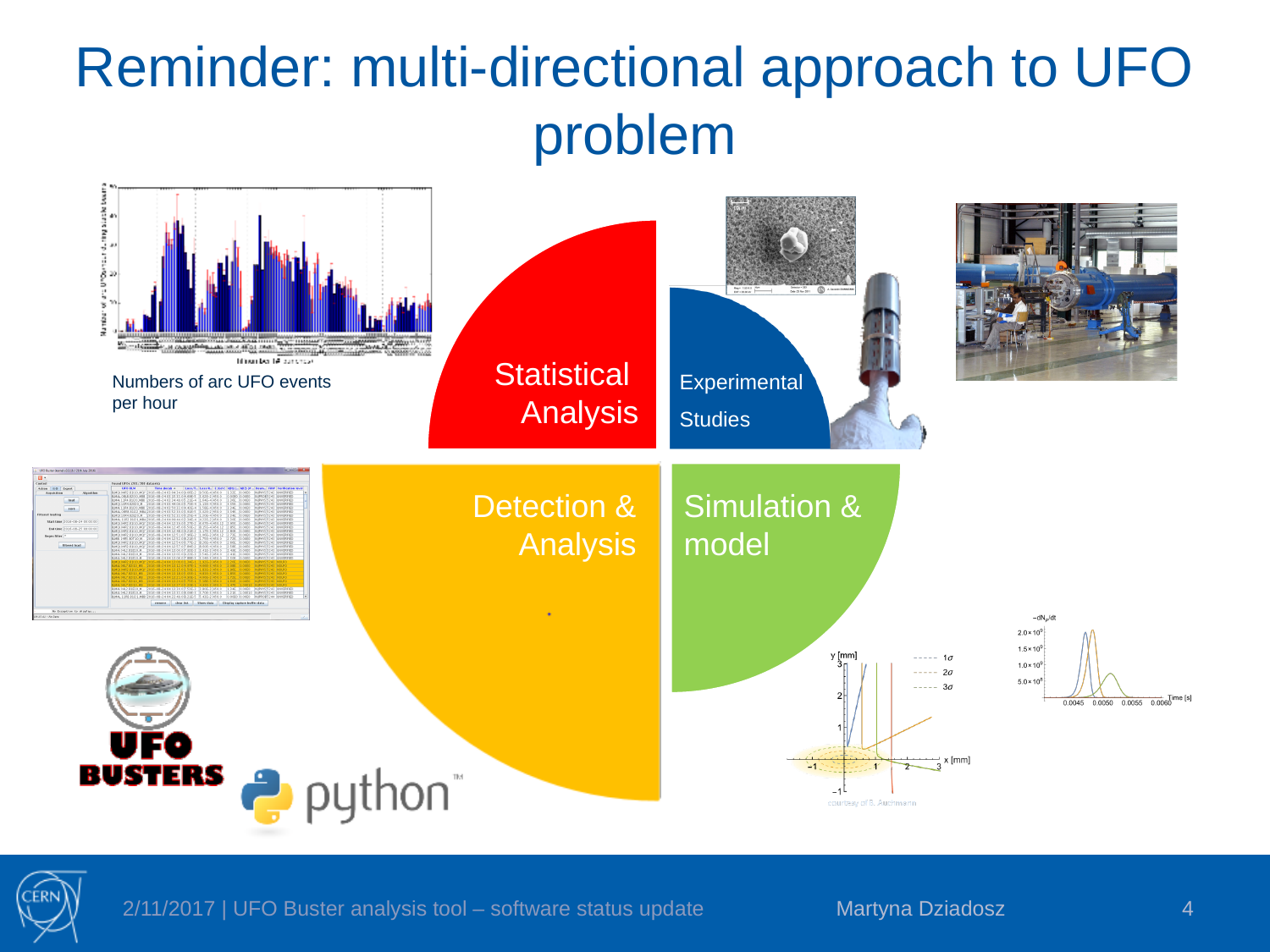
In the line plot at the far right of the slide, is the peak of the blue curve at a time less or greater than 0.0050 s? less In the line plot at the far right of the slide, which curve peaks at the latest time: the blue, the orange or the green one? green In the plot at the bottom-right with axes x [mm] and y [mm], what is the label of the horizontal axis? x [mm] What kind of chart is the chart in the top-left of the slide, captioned 'Numbers of arc UFO events per hour'? bar chart In the plot at the bottom-right with axes x [mm] and y [mm], what are the legend entries? 1σ, 2σ, 3σ In the plot at the bottom-right with axes x [mm] and y [mm], how many entries does the legend list? 3 In the line plot at the far right of the slide, how many curves are plotted? 3 What is the caption printed below the bar chart in the top-left of the slide? Numbers of arc UFO events per hour